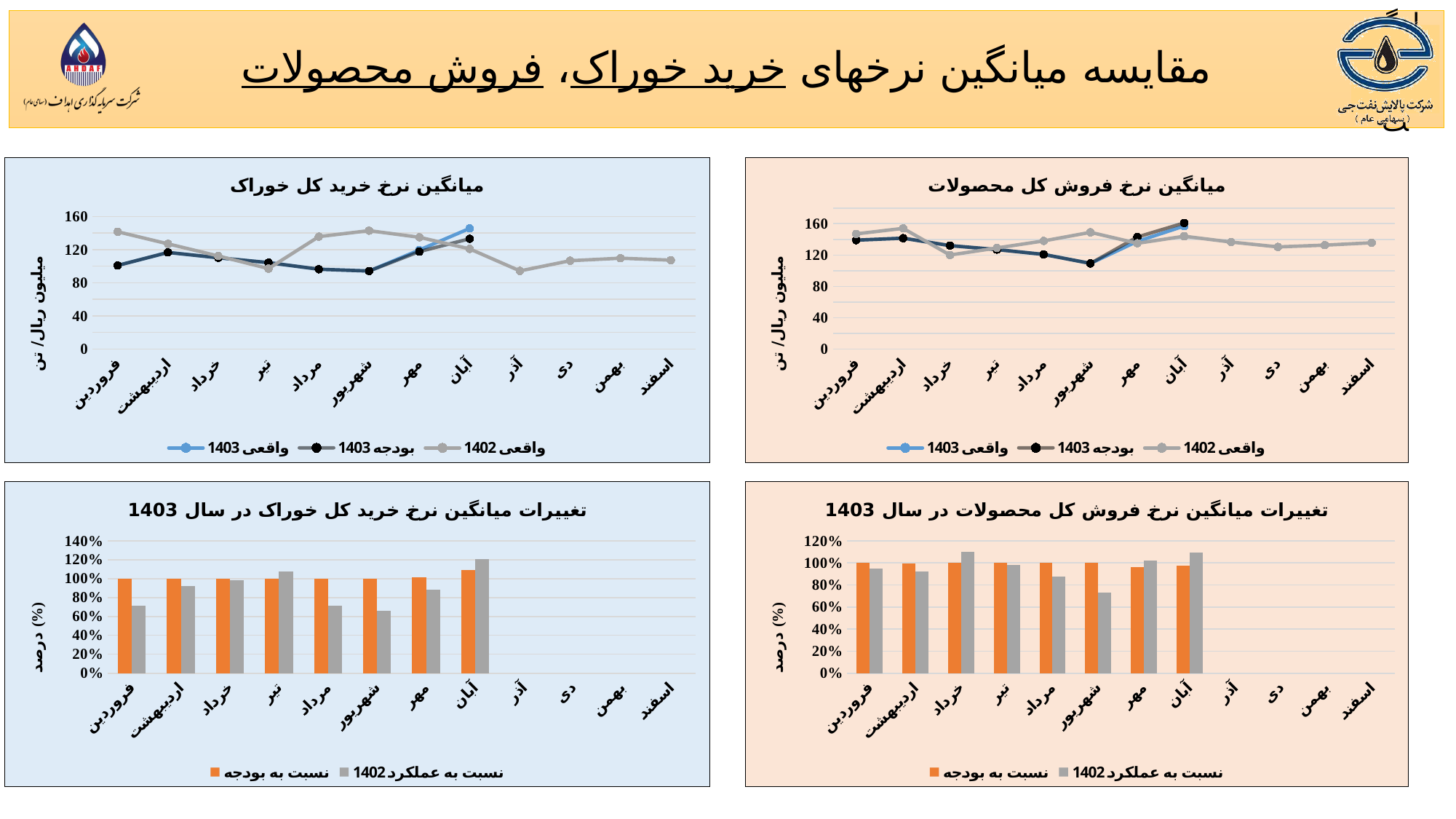
How many series does the legend of the top-left chart 'میانگین نرخ خرید کل خوراک' list? 3 What kind of chart is the top-left chart titled 'میانگین نرخ خرید کل خوراک'? line chart In the top-right chart 'میانگین نرخ فروش کل محصولات', is the value of بودجه 1403 for شهریور greater or less than 120? less In the bottom-right chart 'تغییرات میانگین نرخ فروش کل محصولات در سال 1403', which series has the larger value for خرداد: نسبت به بودجه or نسبت به عملکرد 1402? نسبت به عملکرد 1402 In the bottom-left chart 'تغییرات میانگین نرخ خرید کل خوراک در سال 1403', is the value of نسبت به عملکرد 1402 for آبان greater or less than 100%? greater How many months are shown on the x axis of the top-right chart 'میانگین نرخ فروش کل محصولات'? 12 How many series does the legend of the bottom-right chart 'تغییرات میانگین نرخ فروش کل محصولات در سال 1403' list? 2 What kind of chart is the bottom-left chart titled 'تغییرات میانگین نرخ خرید کل خوراک در سال 1403'? bar chart How many months have bars plotted in the bottom-right chart 'تغییرات میانگین نرخ فروش کل محصولات در سال 1403'? 8 In the bottom-left chart 'تغییرات میانگین نرخ خرید کل خوراک در سال 1403', is the value of نسبت به عملکرد 1402 for شهریور greater or less than 80%? less